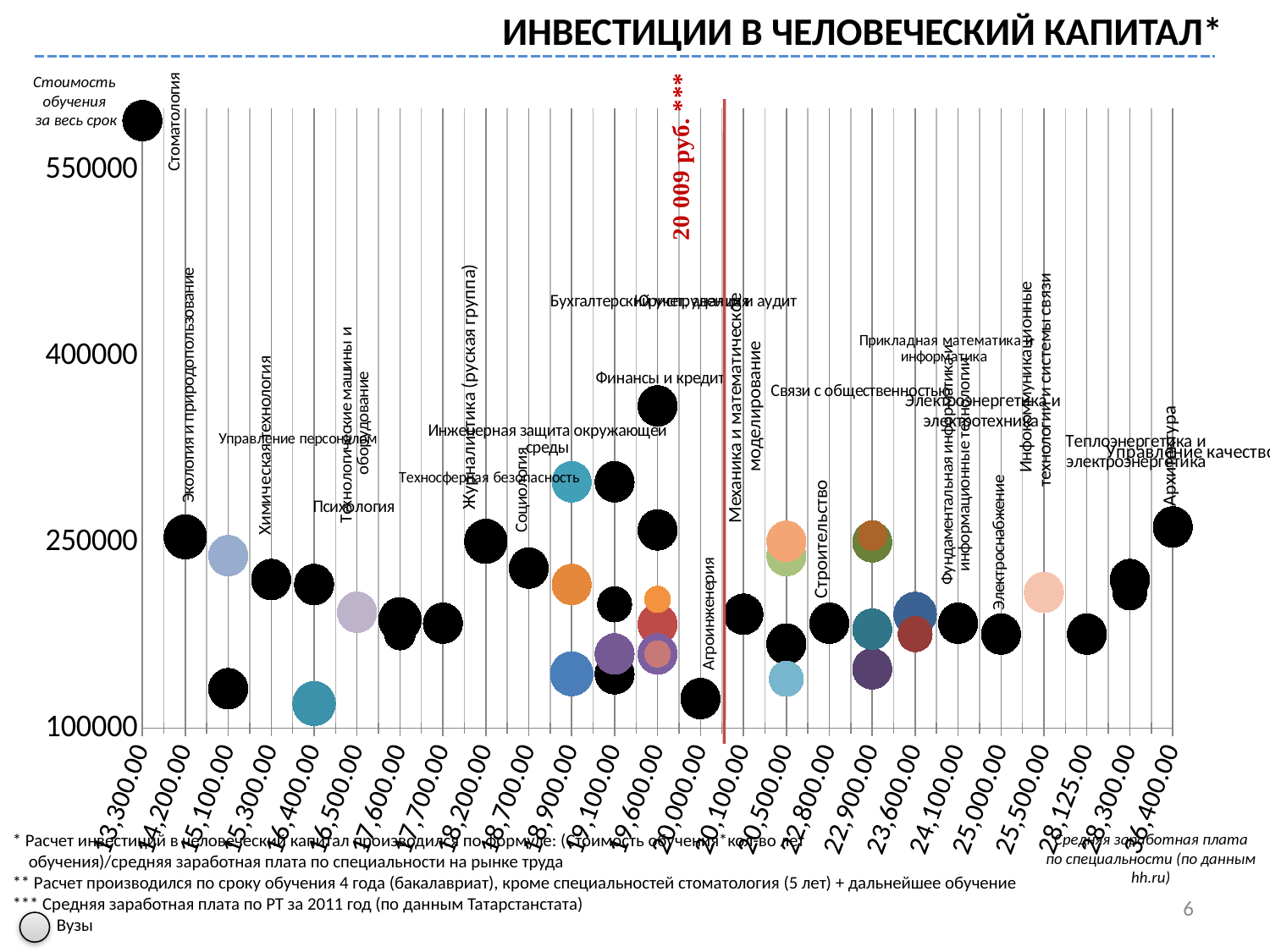
Which has the higher training cost, Финансы и кредит or Агроинженерия? Финансы и кредит What salary value is marked by the red vertical line on the chart? 20 009 руб. What kind of chart is shown on the slide? bubble (scatter) chart Is the training cost for Финансы и кредит greater or less than 400000? less Is the training cost for Агроинженерия greater or less than 250000? less Which specialty has the highest training cost on the chart? Стоматология Is the training cost for Стоматология greater or less than 550000? greater What is the title of the chart on the slide? ИНВЕСТИЦИИ В ЧЕЛОВЕЧЕСКИЙ КАПИТАЛ* Which has the higher training cost, Стоматология or Финансы и кредит? Стоматология